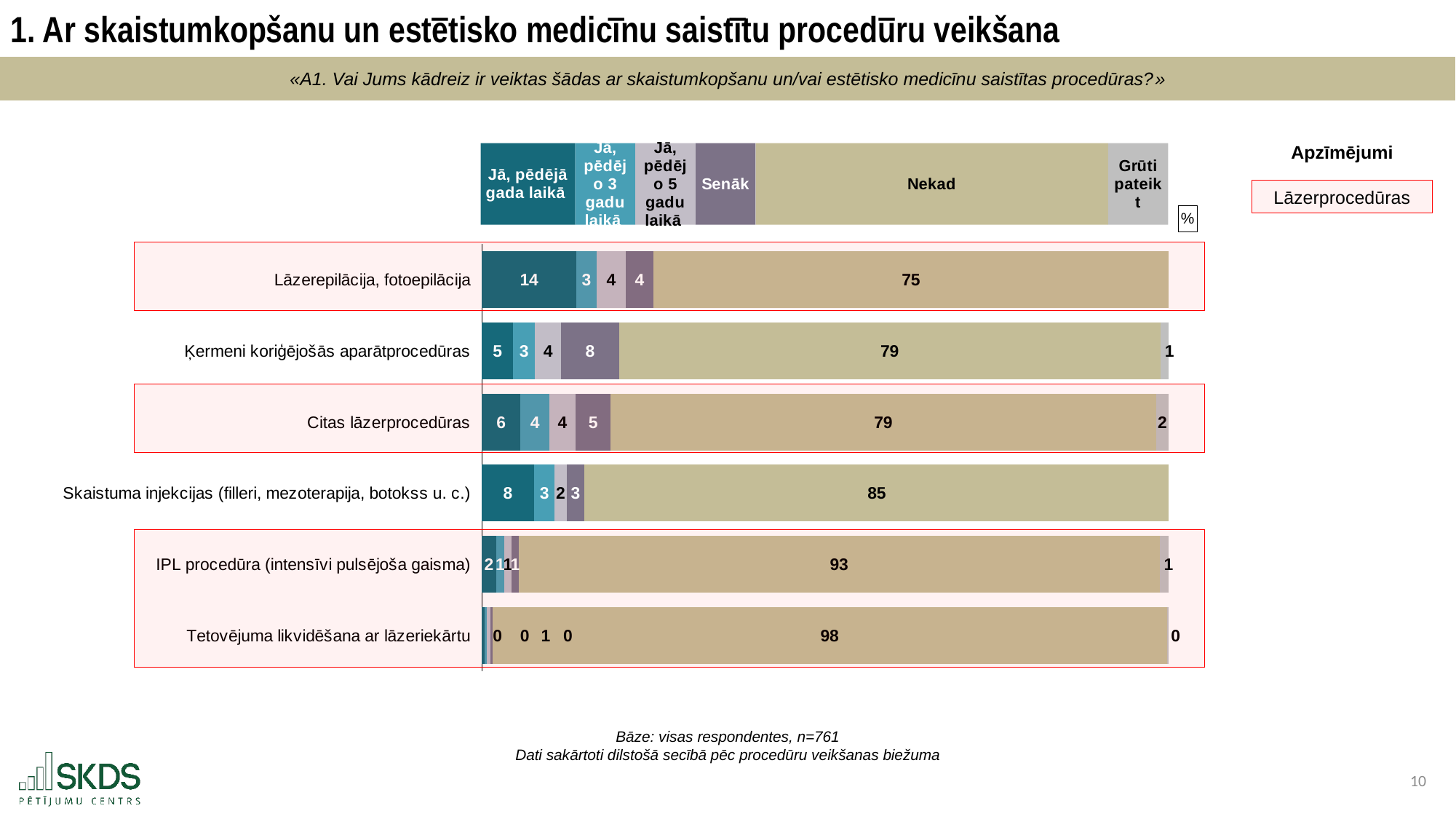
What is the 'Senāk' value for Ķermeni koriģējošās aparātprocedūras? 8 What kind of chart is shown on the slide? Stacked bar chart What does the 'Apzīmējumi' box on the right of the chart label? Lāzerprocedūras What is the difference between the 'Nekad' values for IPL procedūra (intensīvi pulsējoša gaisma) and Lāzerepilācija, fotoepilācija? 18 How many series does the chart's legend list? 6 What is the 'Jā, pēdējā gada laikā' value for Skaistuma injekcijas (filleri, mezoterapija, botokss u. c.)? 8 Which procedure has the highest 'Jā, pēdējā gada laikā' value? Lāzerepilācija, fotoepilācija Which is larger: the 'Jā, pēdējā gada laikā' value for Citas lāzerprocedūras or for Ķermeni koriģējošās aparātprocedūras? Citas lāzerprocedūras What is the 'Nekad' value for Lāzerepilācija, fotoepilācija? 75 What is the 'Grūti pateikt' value for Citas lāzerprocedūras? 2 Which procedure has the highest 'Nekad' value? Tetovējuma likvidēšana ar lāzeriekārtu How many procedure categories are plotted in the chart? 6